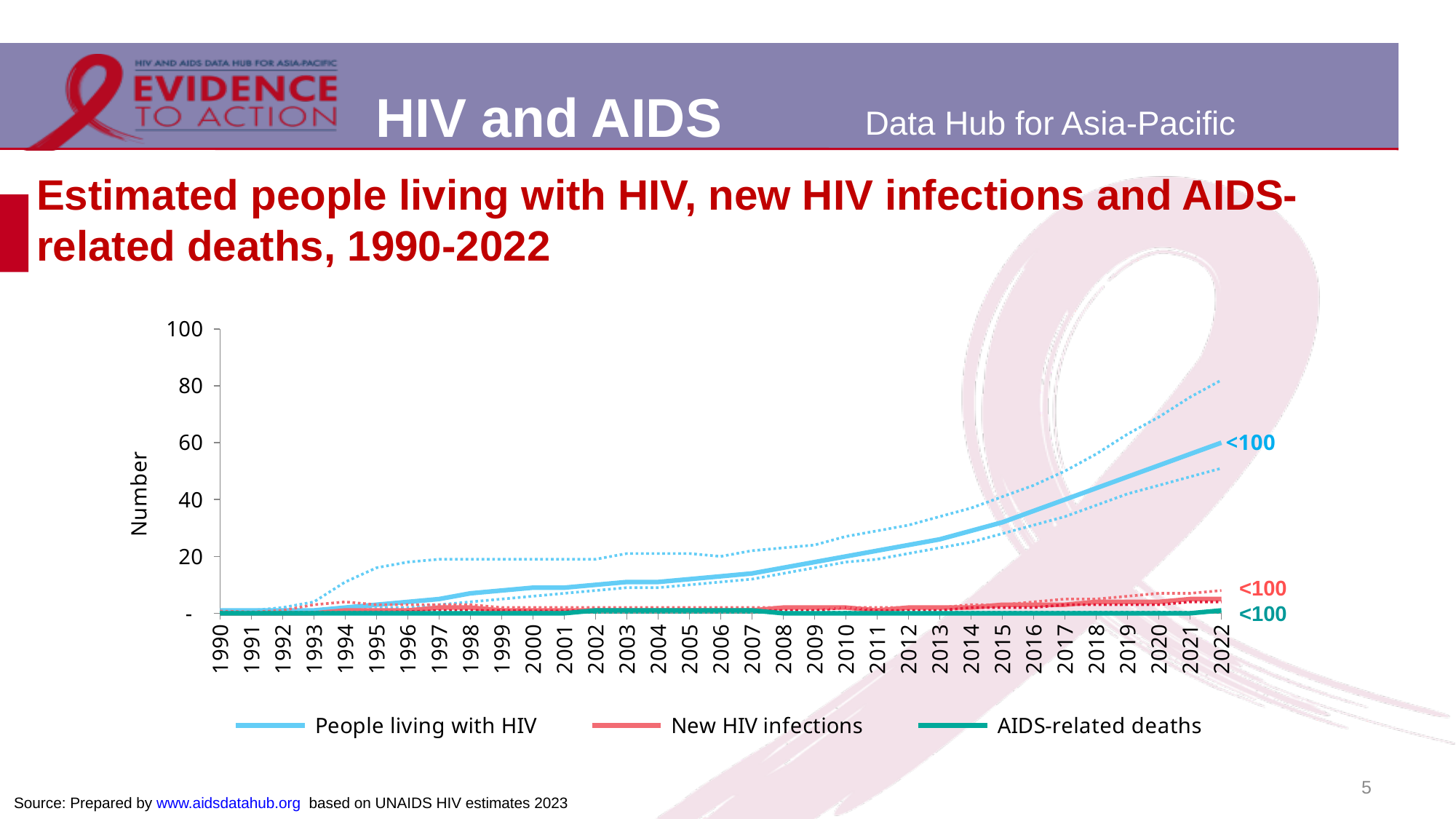
How many years are shown along the x axis? 33 Is the value for New HIV infections in 2022 greater or less than 20? less Is the value for People living with HIV in 2022 greater or less than 40? greater How many series does the legend list? 3 In 2022, which is larger: People living with HIV or New HIV infections? People living with HIV Is the value for People living with HIV in 2000 greater or less than 20? less What is the label on the vertical axis? Number What kind of chart is shown on the slide? Line chart Which series has the highest value in 2022? People living with HIV What is the title of the chart? Estimated people living with HIV, new HIV infections and AIDS-related deaths, 1990-2022 Which series has the lowest value in 2022? AIDS-related deaths Does the People living with HIV line rise or fall from 1990 to 2022? Rises